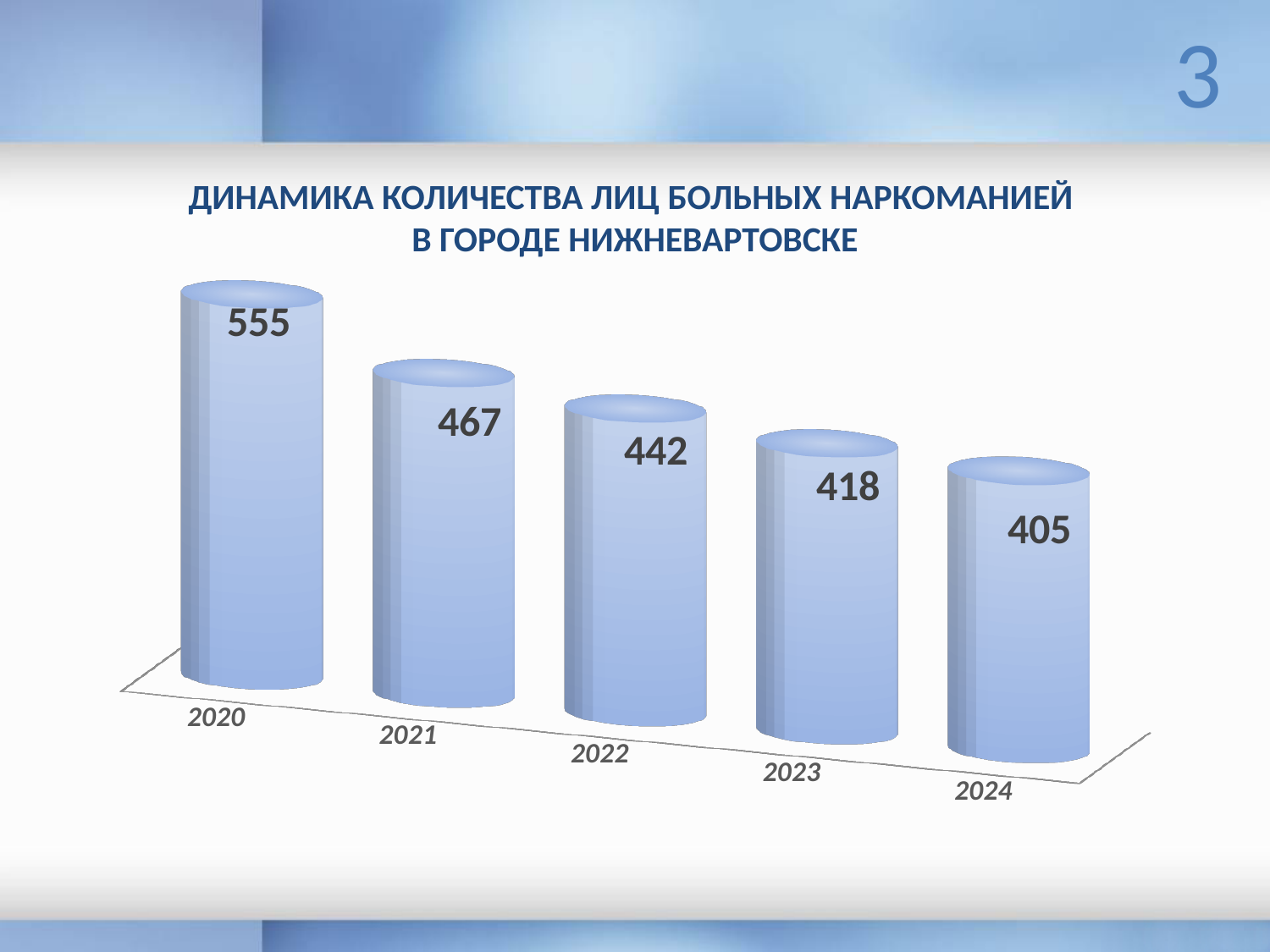
What kind of chart is shown on the slide? Bar chart What is the difference between the values for 2020 and 2021? 88 How many years are shown on the chart? 5 Which year has the lowest value? 2024 Do the values rise or fall from 2020 to 2024? Fall Which year has the highest value? 2020 What is the value for 2024? 405 What is the value for 2020? 555 What is the value for 2022? 442 What is the title of the chart? ДИНАМИКА КОЛИЧЕСТВА ЛИЦ БОЛЬНЫХ НАРКОМАНИЕЙ В ГОРОДЕ НИЖНЕВАРТОВСКЕ What is the difference between the values for 2023 and 2024? 13 Which is larger, the value for 2021 or the value for 2022? 2021